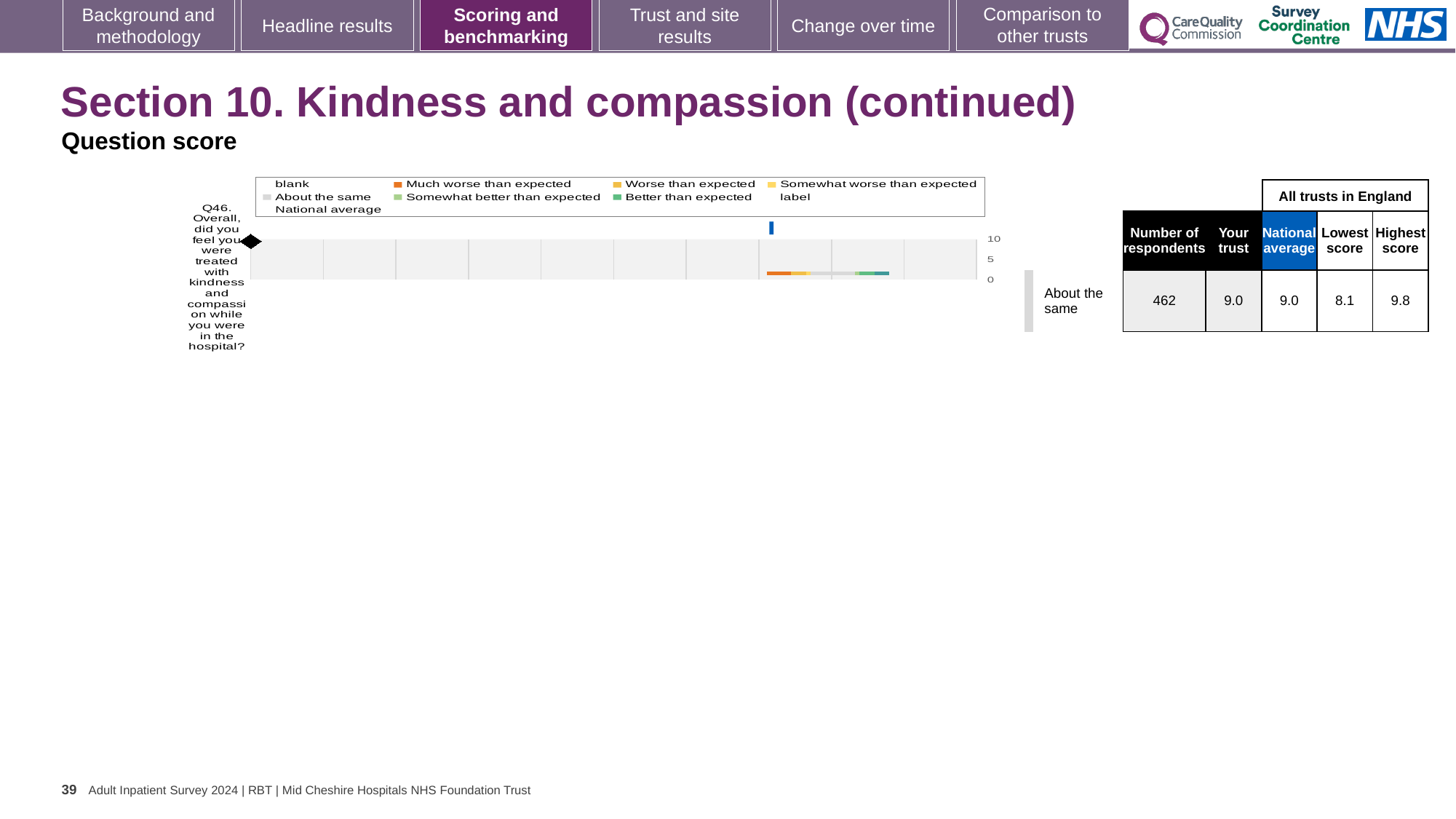
How many survey questions are plotted on the chart? 1 Which question is plotted on the chart? Q46. Overall, did you feel you were treated with kindness and compassion while you were in the hospital? What is the 'Your trust' score for Q46? 9.0 What is the highest score among all trusts in England for Q46? 9.8 What is the lowest score among all trusts in England for Q46? 8.1 What is the highest value shown on the chart's axis? 10 What kind of chart is shown on the slide? bar chart What is the difference between the highest score and the lowest score for Q46? 1.7 What is the national average score for Q46? 9.0 What benchmark category is the trust's Q46 score assigned to? About the same Is the national average marker for Q46 greater or less than 5 on the axis? greater How many respondents answered Q46? 462